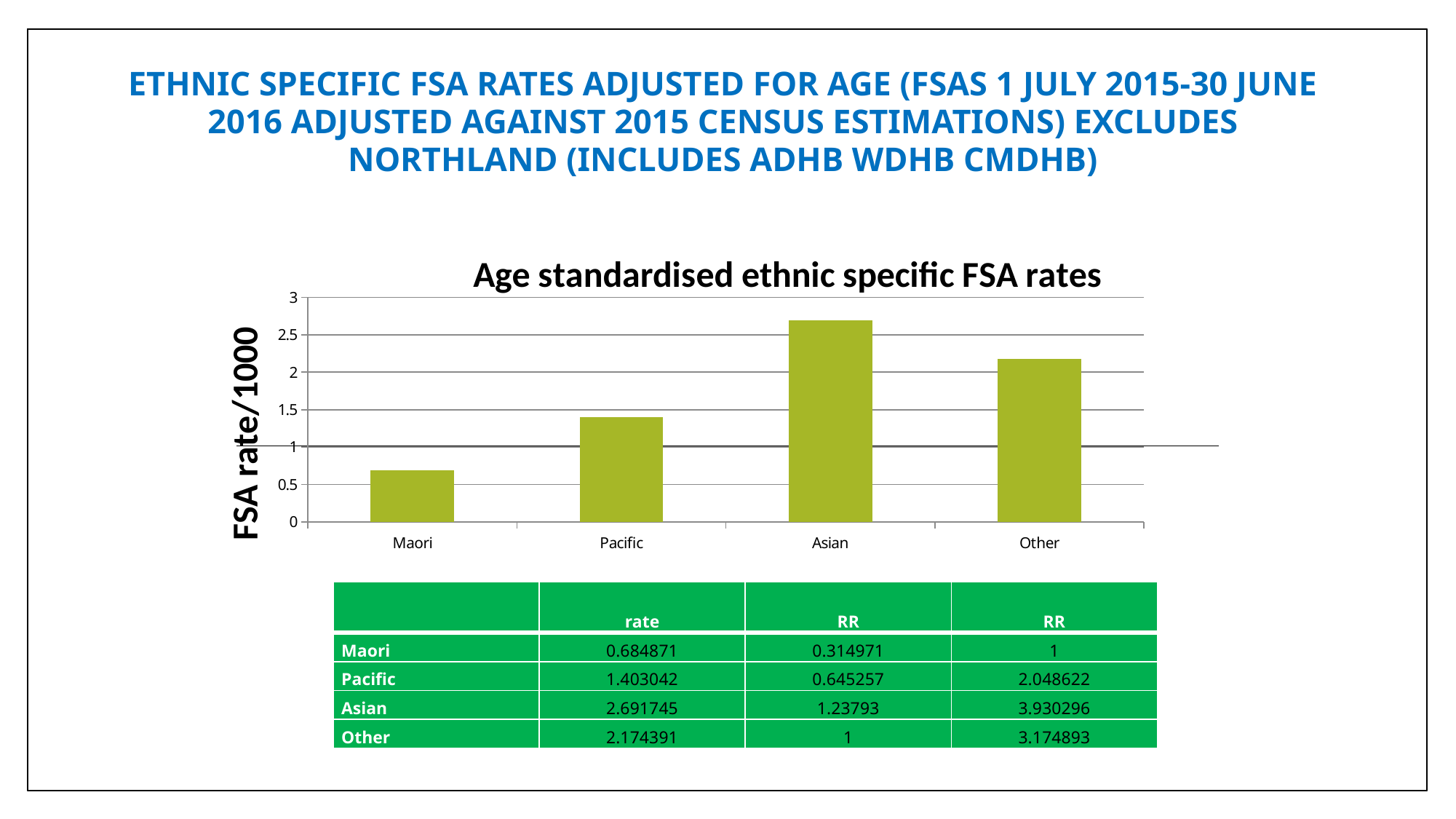
Is the FSA rate for Asian greater or less than 2.5? greater According to the table on the slide, what is the FSA rate for Pacific? 1.403042 Which has a higher FSA rate, Pacific or Other? Other What type of chart is shown on the slide? bar chart Is the FSA rate for Maori greater or less than 1? less According to the table on the slide, what is the FSA rate for Asian? 2.691745 Using the rates in the table, what is the difference between the Asian and Maori FSA rates? 2.006874 How many ethnic groups are plotted in the chart? 4 What is the label on the vertical axis of the chart? FSA rate/1000 Which ethnic group has the lowest age standardised FSA rate? Maori Which ethnic group has the highest age standardised FSA rate? Asian According to the table on the slide, what is the FSA rate for Other? 2.174391